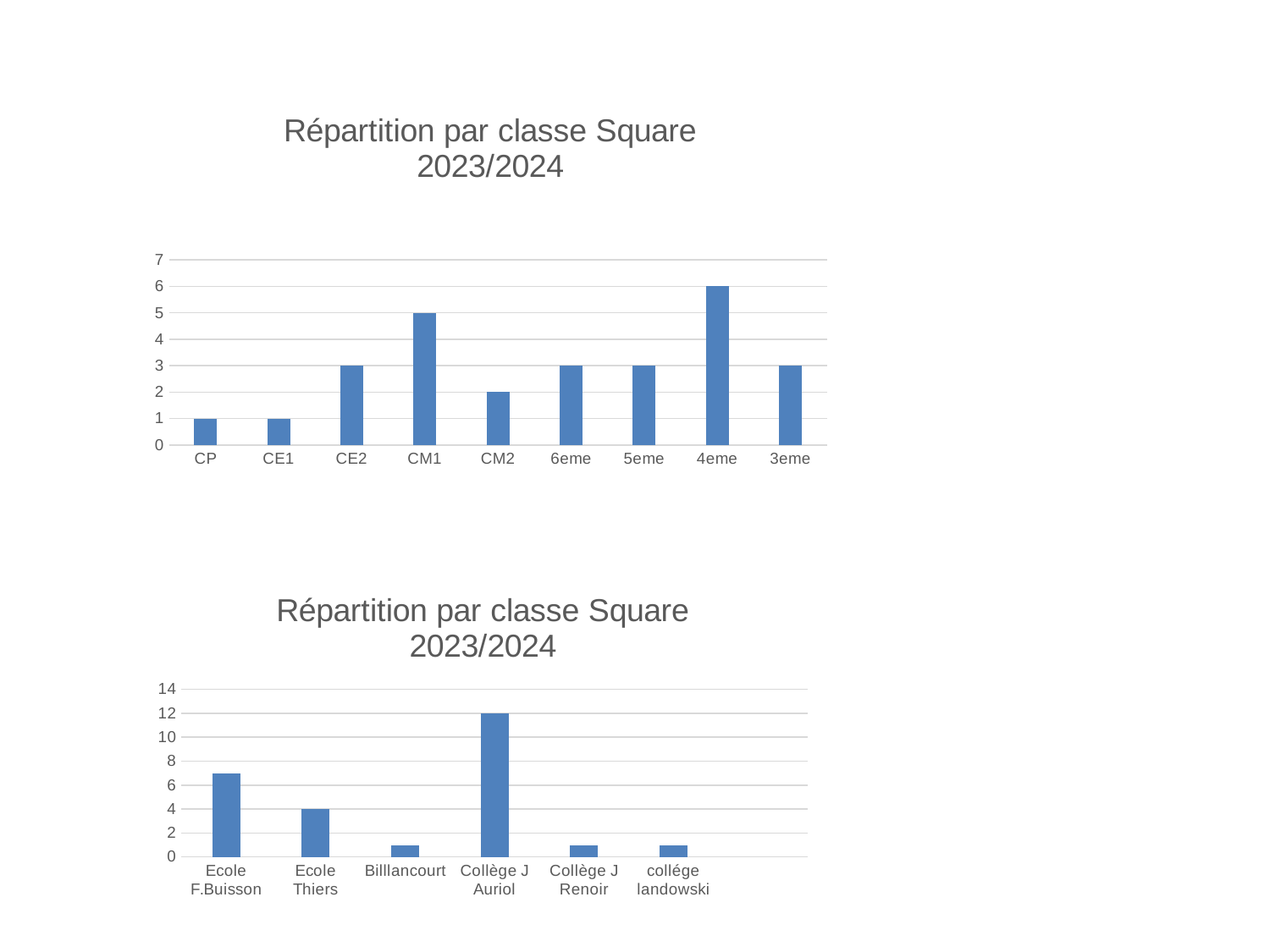
In the bottom chart, what is the value for Ecole Thiers? 4 In the bottom chart, is the value for Ecole F.Buisson greater or less than 6? greater In the bottom chart, which school has the highest value? Collège J Auriol In the top chart, which is larger, the value for CE2 or the value for CM2? CE2 What kind of chart is the top chart on the slide? bar chart In the top chart, what is the value for 4eme? 6 In the bottom chart, what is the value for Collège J Auriol? 12 In the top chart, what is the value for CM1? 5 In the top chart, which class has the highest value? 4eme In the bottom chart, how many schools are shown on the x axis? 6 In the top chart, what is the difference between the values for 4eme and CM2? 4 In the top chart, how many classes are shown on the x axis? 9